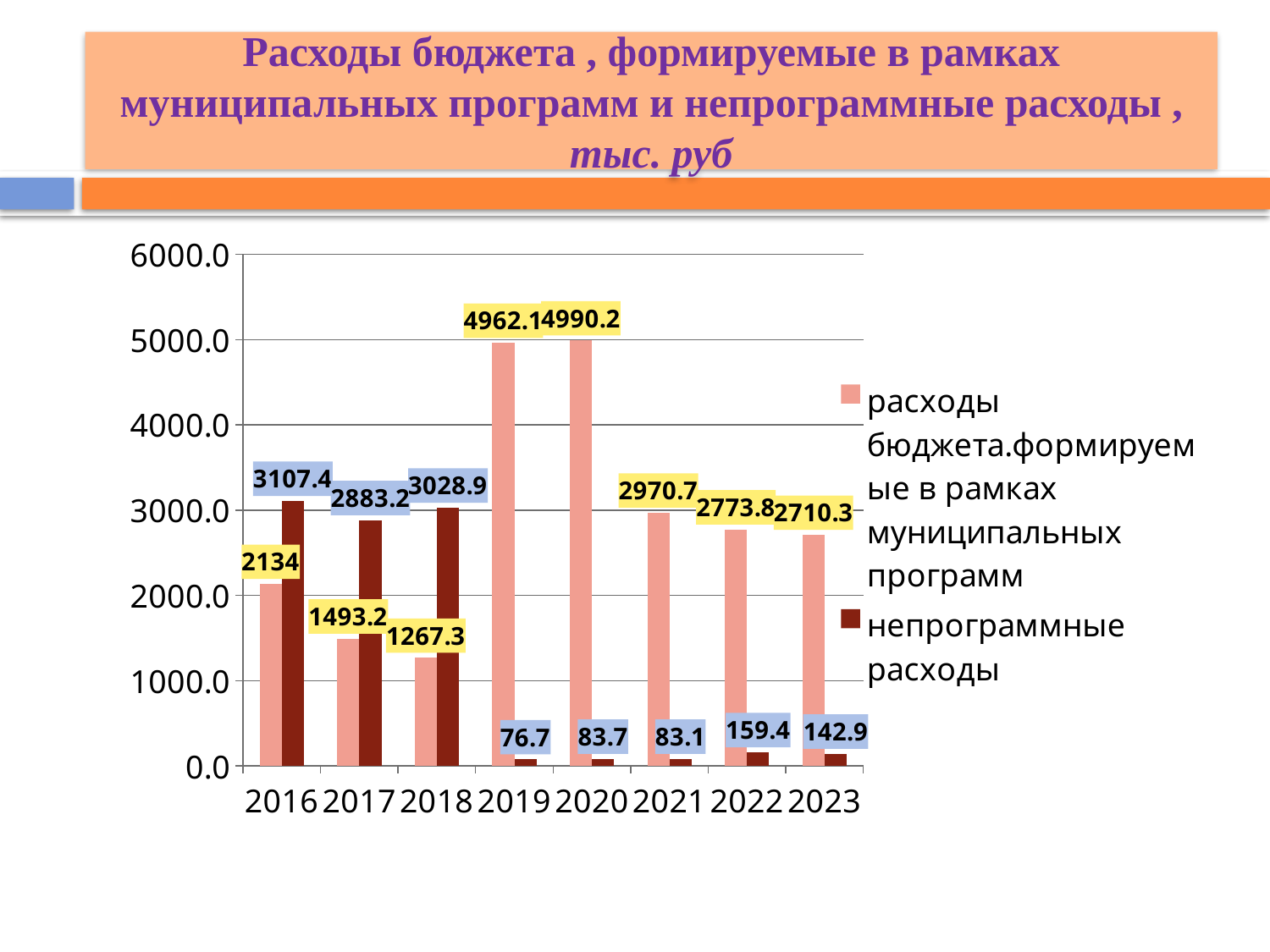
What is the value of the program-based budget expenses for 2023? 2710.3 What kind of chart is shown on the slide? bar chart What is the value of non-program expenses (непрограммные расходы) for 2022? 159.4 Which is larger in 2017: the program-based budget expenses or the non-program expenses? непрограммные расходы How many years are shown on the x axis? 8 What is the value of the program-based budget expenses (расходы бюджета, формируемые в рамках муниципальных программ) for 2016? 2134 In which year are the non-program expenses the lowest? 2019 What is the difference between the program-based budget expenses in 2020 and in 2019? 28.1 What is the value of non-program expenses (непрограммные расходы) for 2018? 3028.9 In which year are the program-based budget expenses the highest? 2020 Do the non-program expenses rise or fall from 2018 to 2019? fall How many series does the legend list? 2